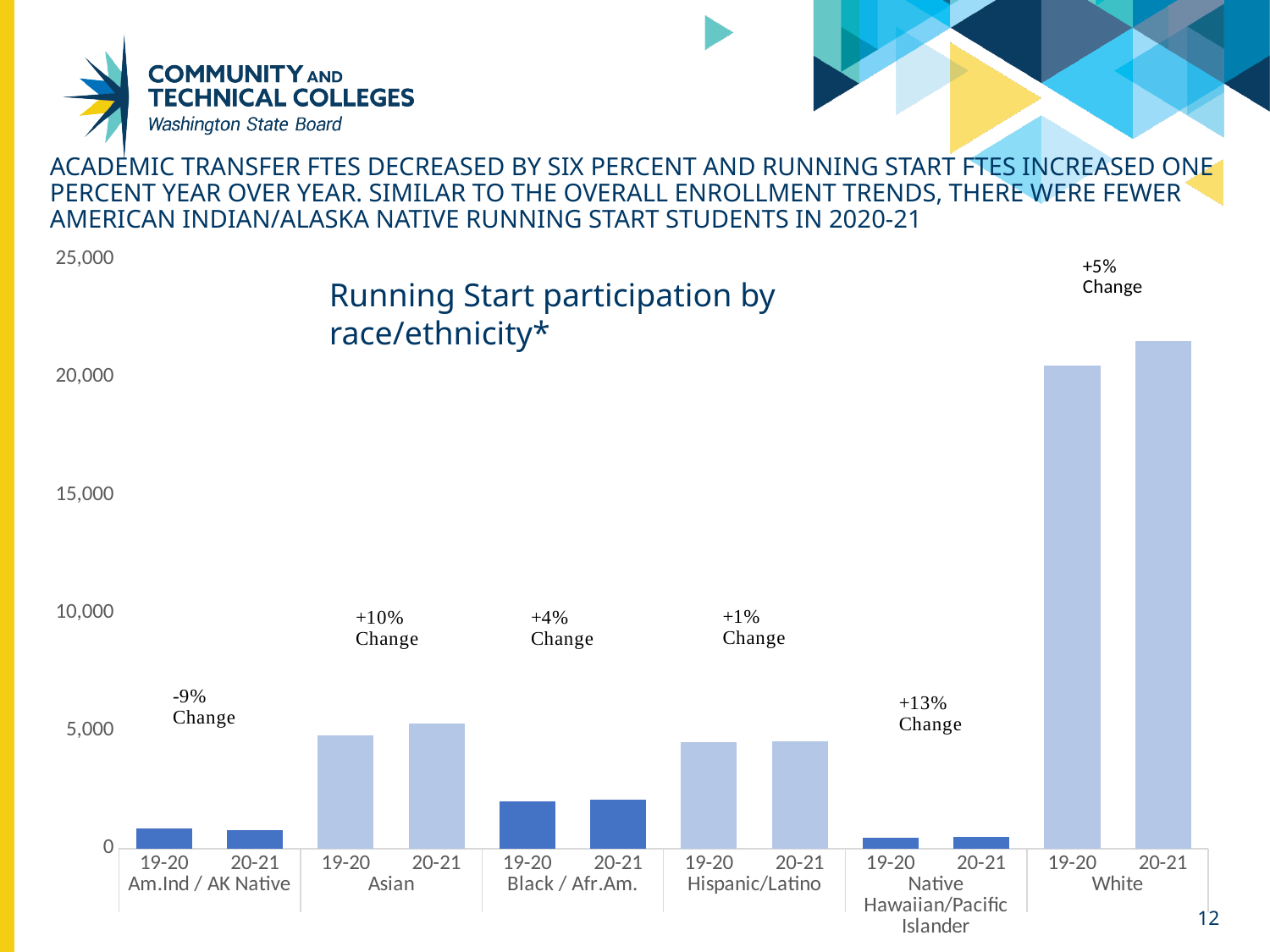
Which bar is the tallest in the chart? White 20-21 Is the value for White 20-21 greater or less than 20,000? greater Is the value for Black / Afr.Am. 19-20 greater or less than 5,000? less How many race/ethnicity groups are shown on the x axis of the chart? 6 What percent change is annotated for the Am.Ind / AK Native group? -9% What kind of chart is shown on the slide? bar chart How many bars are plotted in the chart in total? 12 What percent change is annotated for the Native Hawaiian/Pacific Islander group? +13% What percent change is annotated for the Asian group? +10% Which bar is the shortest in the chart? Native Hawaiian/Pacific Islander 19-20 Which is larger, the Asian 19-20 bar or the Asian 20-21 bar? Asian 20-21 What is the title of the chart? Running Start participation by race/ethnicity*